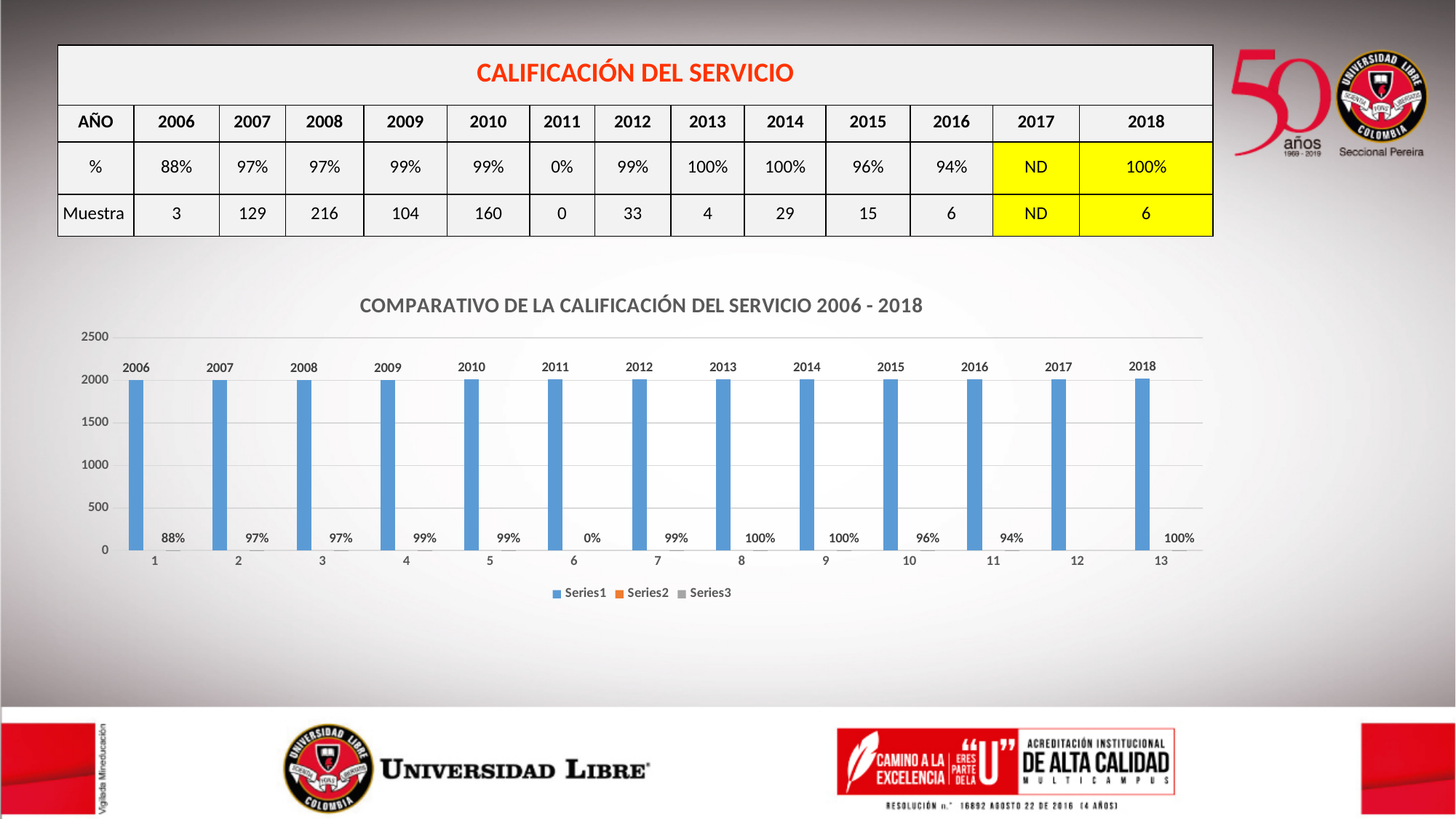
What percentage label is shown at the base of the bar labeled 2013? 100% What percentage label is shown at the base of the bar labeled 2006? 88% What are the names of the series listed in the legend? Series1, Series2, Series3 What year label appears above the bar at category 1? 2006 How many bars are plotted in the chart? 13 What percentage label is shown at the base of the bar labeled 2011? 0% What is the title of the chart? COMPARATIVO DE LA CALIFICACIÓN DEL SERVICIO 2006 - 2018 What year label appears above the bar at category 13? 2018 How many series does the chart legend list? 3 What percentage label is shown at the base of the bar labeled 2016? 94% Is the value of the bar labeled 2010 greater or less than 1500? greater What kind of chart is shown on the slide? bar chart